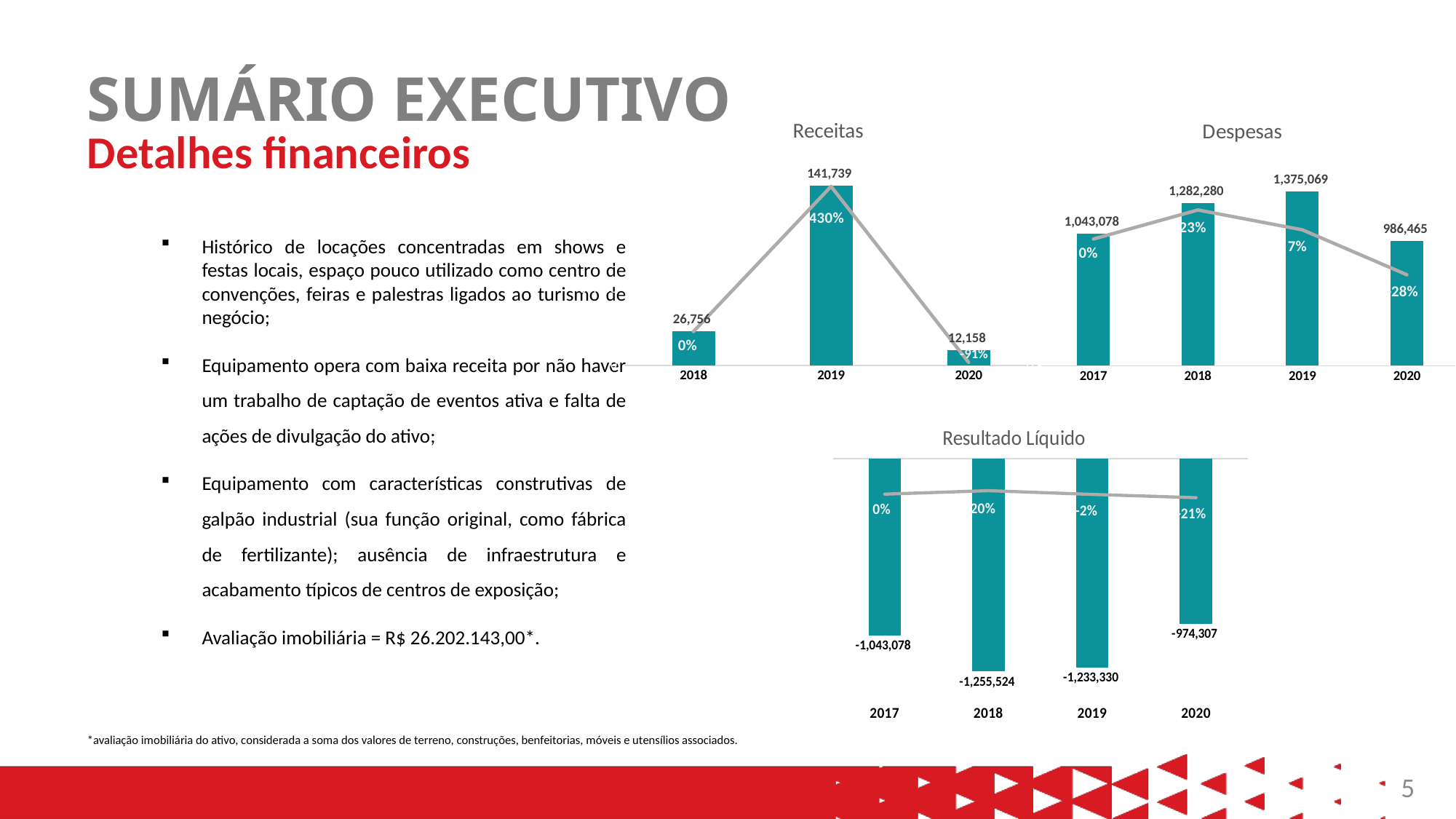
In the Receitas chart, which year has the lowest value? 2020 What kind of chart is the Receitas chart? Bar chart with a line overlay In the Receitas chart, what is the value for 2019? 141,739 In the Resultado Líquido chart, which year has the value closest to zero (the highest value)? 2020 In the Resultado Líquido chart, what is the difference between the 2019 and 2020 values? 259,023 In the Receitas chart, what percentage label is shown on the 2019 bar? 430% In the Despesas chart, which is larger, the value for 2017 or the value for 2018? 2018 In the Despesas chart, how many years are shown on the x axis? 4 In the Despesas chart, what is the value for 2020? 986,465 In the Despesas chart, which year has the highest value? 2019 In the Receitas chart, what is the difference between the 2019 and 2018 values? 114,983 In the Resultado Líquido chart, what is the value for 2018? -1,255,524